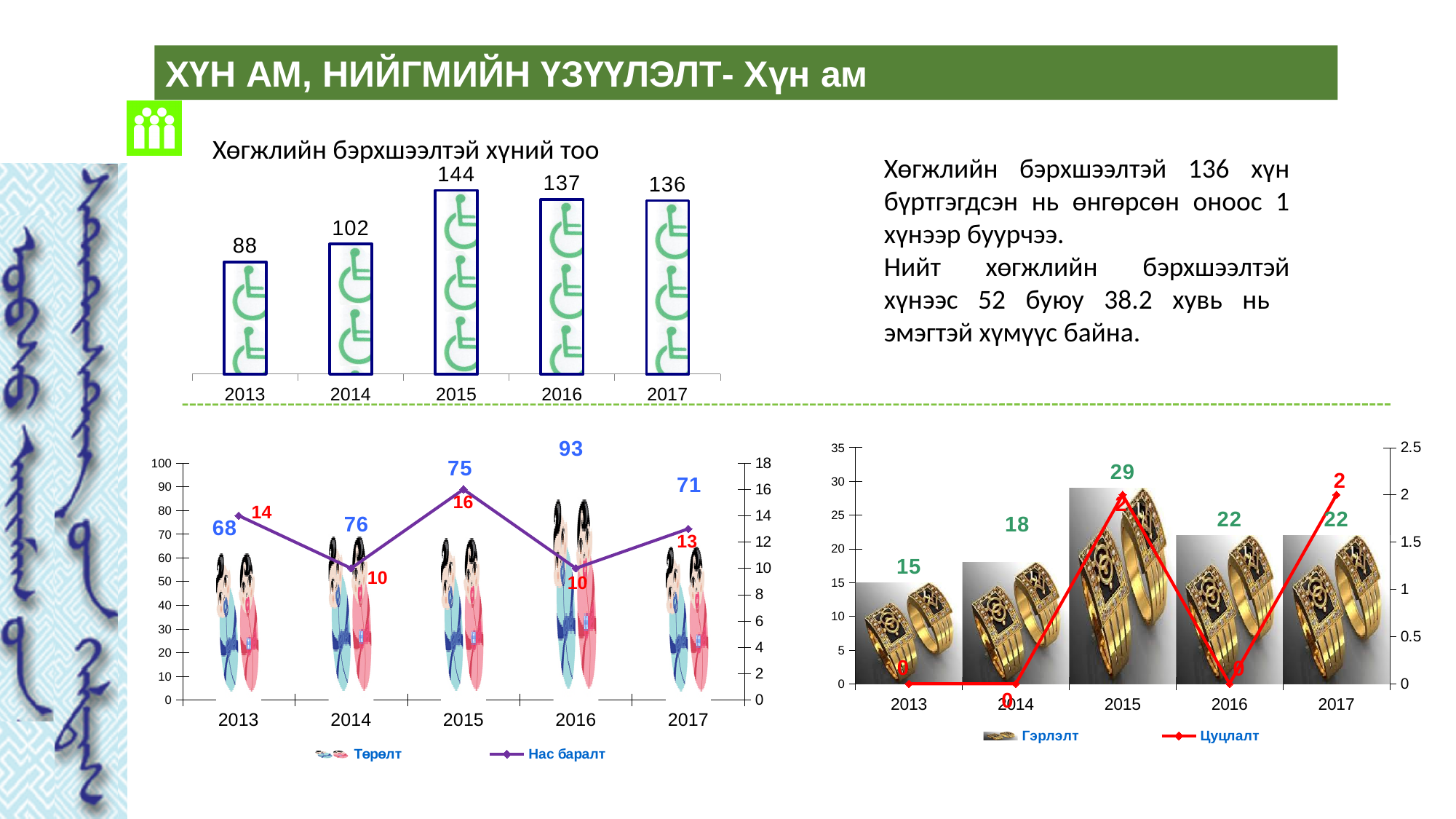
In the bottom-right chart, what is the Гэрлэлт value for 2015? 29 In the chart titled 'Хөгжлийн бэрхшээлтэй хүний тоо', how many years are shown on the x axis? 5 In the chart titled 'Хөгжлийн бэрхшээлтэй хүний тоо', which year has the lowest value? 2013 In the bottom-left chart, how many series does the legend list? 2 In the chart titled 'Хөгжлийн бэрхшээлтэй хүний тоо', what is the value for 2015? 144 In the bottom-right chart, what is the difference between the Гэрлэлт values for 2014 and 2013? 3 In the bottom-left chart, what is the Төрөлт value for 2016? 93 In the bottom-left chart, what is the Нас баралт value for 2015? 16 In the bottom-left chart, which year has the highest Төрөлт value? 2016 In the bottom-left chart, is the Төрөлт value for 2014 larger or smaller than the Төрөлт value for 2015? larger In the bottom-right chart, what is the Цуцлалт value for 2017? 2 In the chart titled 'Хөгжлийн бэрхшээлтэй хүний тоо', what is the difference between the 2015 and 2017 values? 8